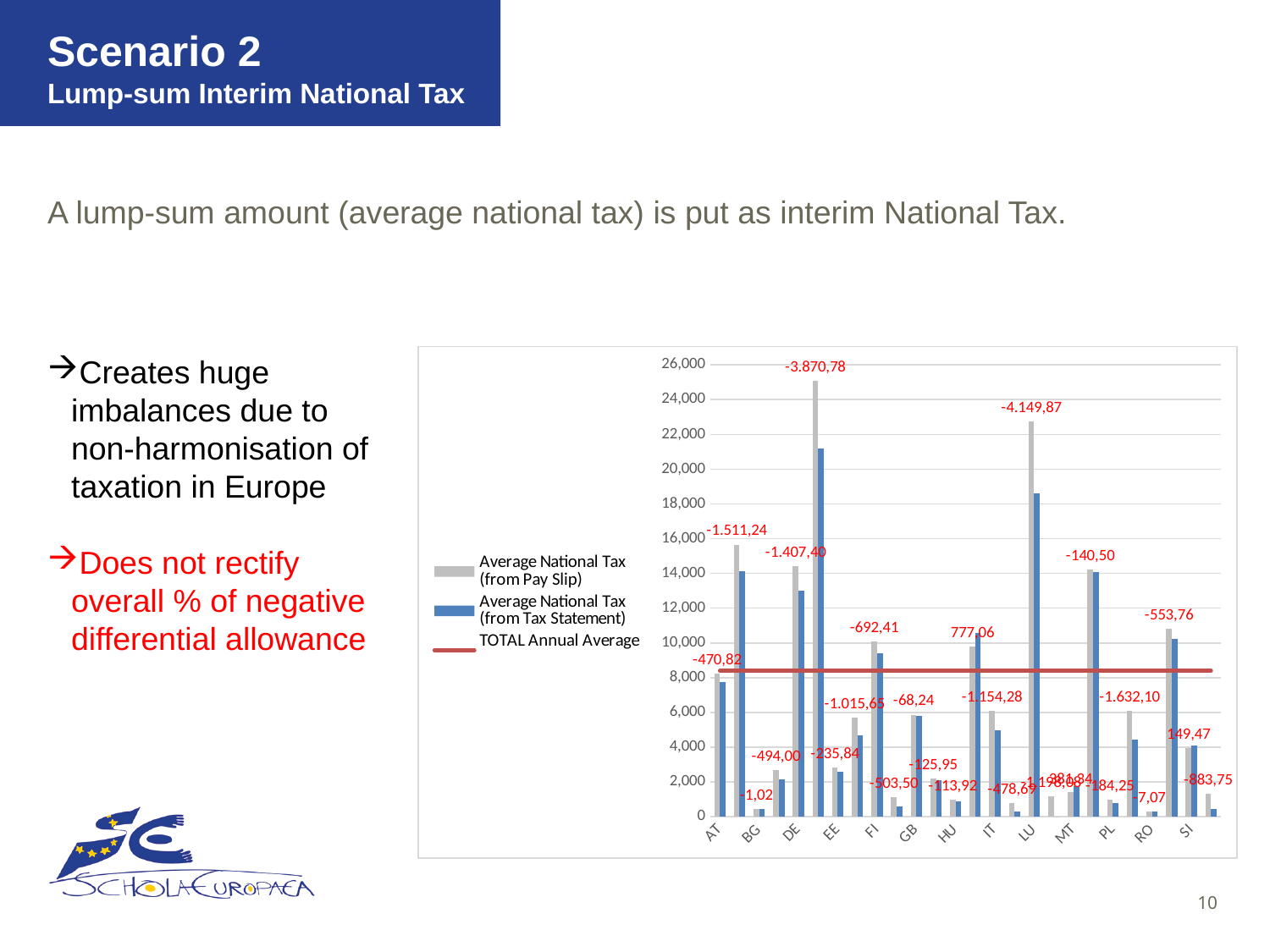
What kind of chart is shown on the slide? bar and line chart Is the Average National Tax (from Pay Slip) for LU greater or less than 22,000? greater Which is larger for DE: the Average National Tax (from Pay Slip) or the Average National Tax (from Tax Statement)? Average National Tax (from Pay Slip) Which country has the larger Average National Tax (from Pay Slip): DE or LU? LU How many entries does the chart's legend list? 3 Is the TOTAL Annual Average line greater or less than 10,000? less Is the Average National Tax (from Tax Statement) for GB greater or less than 8,000? less What colour is the TOTAL Annual Average line in the chart? red